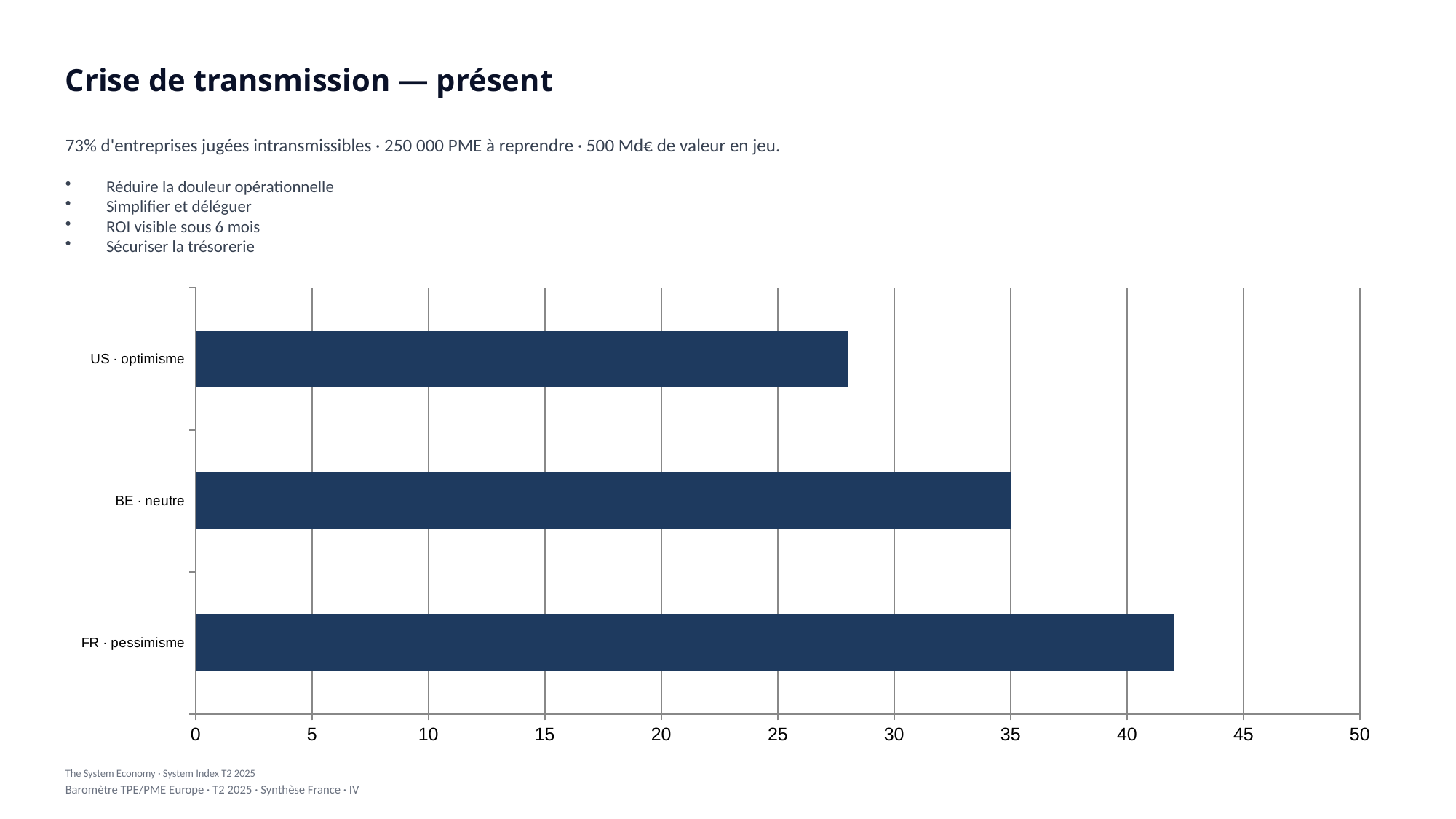
Which is larger, the value for FR · pessimisme or the value for BE · neutre? FR · pessimisme How many categories does the bar chart show? 3 What is the maximum value shown on the horizontal axis? 50 What is the value for BE · neutre? 35 Which category has the highest value? FR · pessimisme Is the value for FR · pessimisme greater or less than 45? less Is the value for FR · pessimisme greater or less than 40? greater Which is larger, the value for BE · neutre or the value for US · optimisme? BE · neutre What kind of chart is shown on the slide? bar chart Is the value for US · optimisme greater or less than 25? greater Which category has the lowest value? US · optimisme